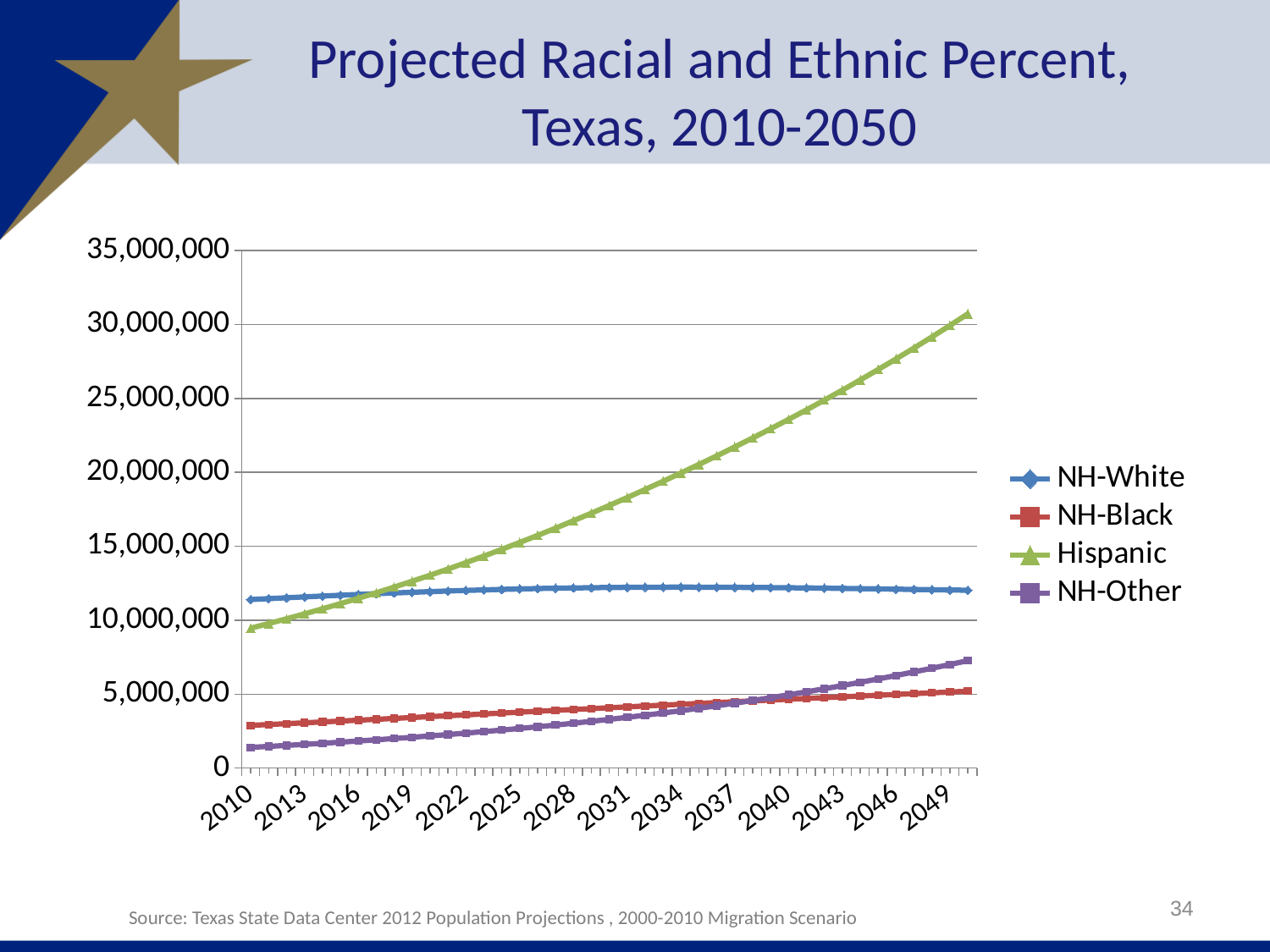
Is the Hispanic value in 2050 greater or less than 25,000,000? greater Does the Hispanic series rise or fall from 2010 to 2050? Rises Which series has the highest value in 2050? Hispanic In 2010, which is larger: NH-White or Hispanic? NH-White What is the title of the chart? Projected Racial and Ethnic Percent, Texas, 2010-2050 In 2050, which is larger: NH-Black or NH-Other? NH-Other Which series has the lowest value in 2010? NH-Other Is the NH-White value in 2010 greater or less than 10,000,000? greater Is the NH-Black value in 2010 greater or less than 5,000,000? less What colour is the Hispanic line? Green How many series does the legend list? 4 What kind of chart is shown on the slide? Line chart